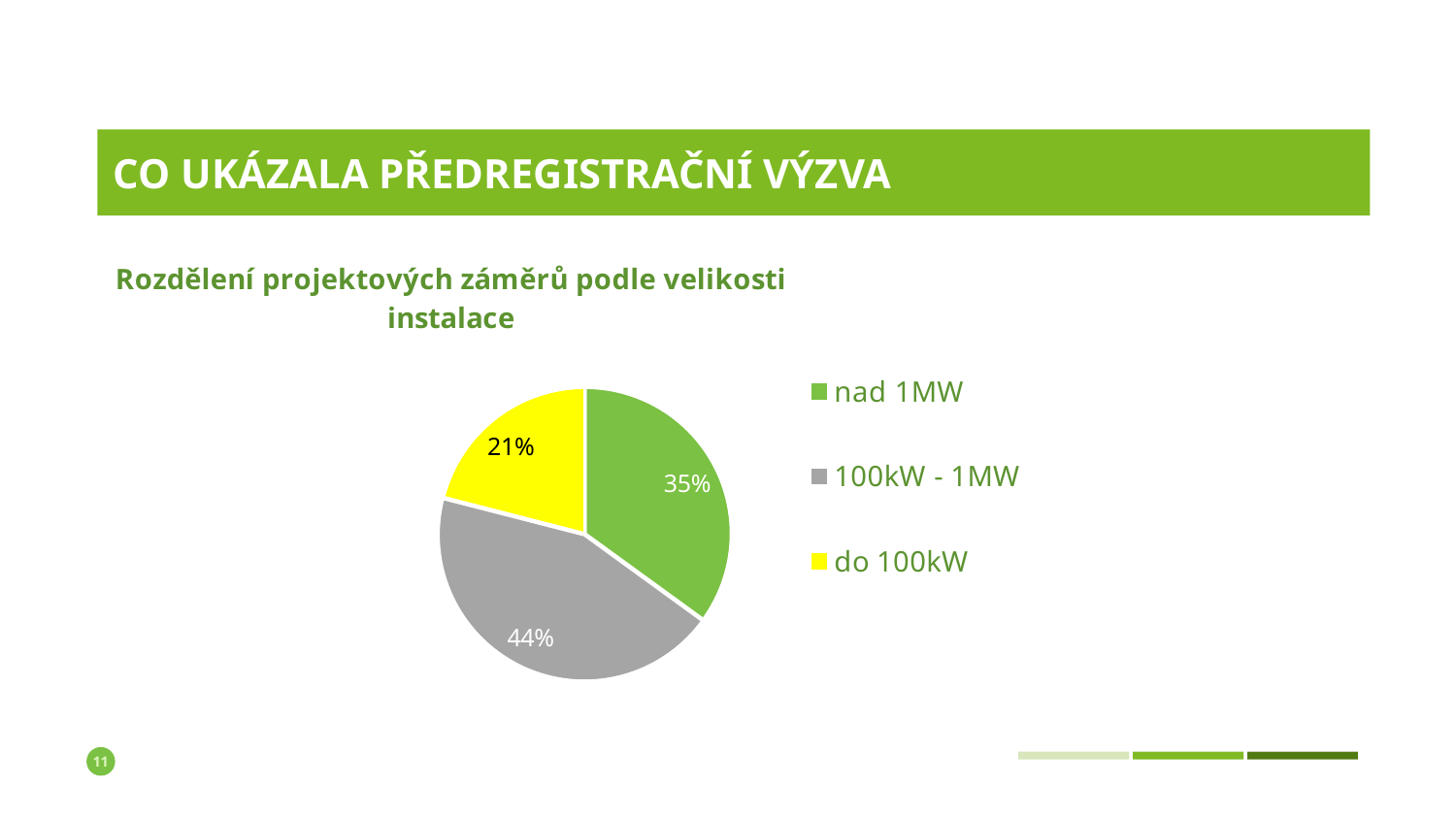
What is the difference in percentage points between the 'nad 1MW' slice and the 'do 100kW' slice? 14 percentage points What share of the pie does the '100kW - 1MW' slice represent? 44% What is the difference in percentage points between the '100kW - 1MW' slice and the 'nad 1MW' slice? 9 percentage points What share of the pie does the 'do 100kW' slice represent? 21% Which category has the smallest share of the pie? do 100kW What is the title of the chart? Rozdělení projektových záměrů podle velikosti instalace Which colour represents the 'do 100kW' category in the pie chart? Yellow Which is larger: the share for 'nad 1MW' or the share for 'do 100kW'? nad 1MW How many slices does the pie chart have? 3 What share of the pie does the 'nad 1MW' slice represent? 35% Which category has the largest share of the pie? 100kW - 1MW What kind of chart is shown on the slide? Pie chart